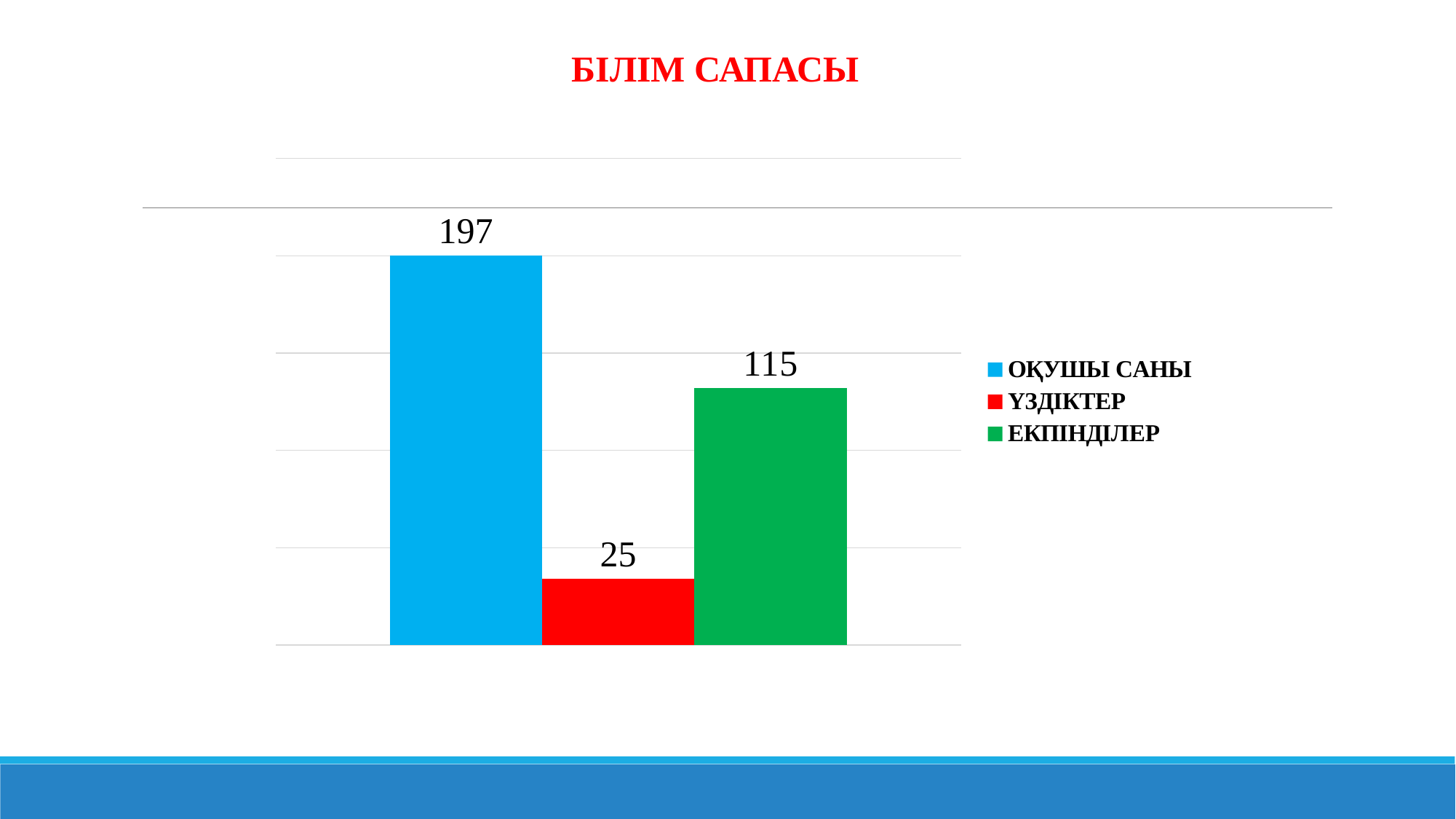
What kind of chart is shown on the slide? bar chart Which is larger, the value for ЕКПІНДІЛЕР or the value for ҮЗДІКТЕР? ЕКПІНДІЛЕР What is the difference between the values for ЕКПІНДІЛЕР and ҮЗДІКТЕР? 90 What is the difference between the values for ОҚУШЫ САНЫ and ЕКПІНДІЛЕР? 82 What is the title of the slide above the chart? БІЛІМ САПАСЫ How many series does the legend list? 3 What is the value for ОҚУШЫ САНЫ? 197 Which series has the lowest value? ҮЗДІКТЕР How many bars are plotted in the chart? 3 Which series has the highest value? ОҚУШЫ САНЫ What is the value for ҮЗДІКТЕР? 25 What is the value for ЕКПІНДІЛЕР? 115